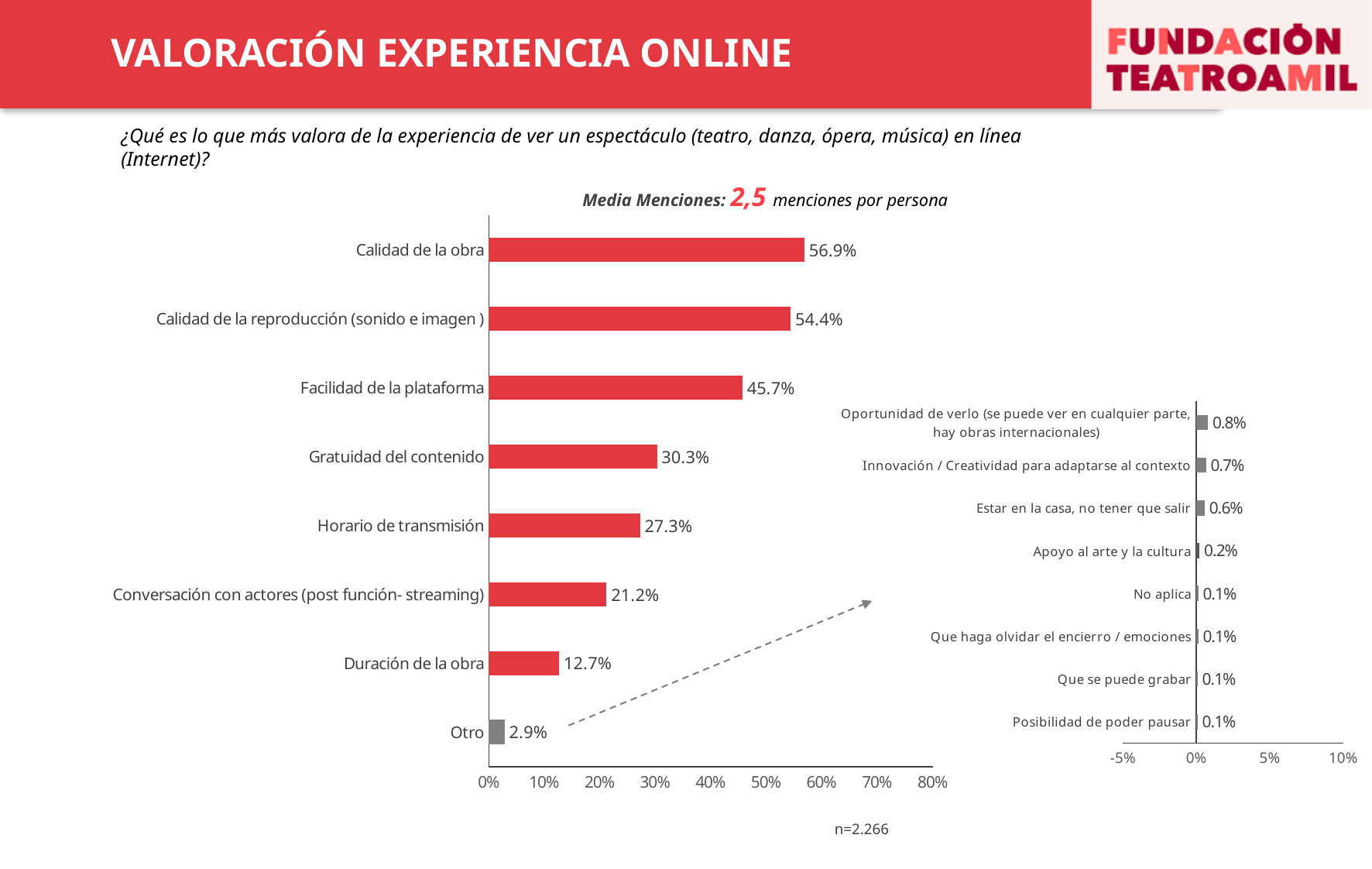
In the main chart on the left, which is larger: Gratuidad del contenido or Horario de transmisión? Gratuidad del contenido In the main chart on the left, what is the value for Calidad de la obra? 56.9% In the main chart on the left, what is the difference between Calidad de la obra and Calidad de la reproducción (sonido e imagen)? 2.5% In the main chart on the left, which category has the lowest value? Otro In the small chart on the right, which category has the highest value? Oportunidad de verlo (se puede ver en cualquier parte, hay obras internacionales) In the small chart on the right, what is the value for Estar en la casa, no tener que salir? 0.6% In the main chart on the left, which category has the highest value? Calidad de la obra In the small chart on the right, how many categories are shown? 8 In the main chart on the left, how many categories are shown? 8 What kind of chart is the main chart on the left? Bar chart In the main chart on the left, what is the value for Facilidad de la plataforma? 45.7% What is the Media Menciones (average mentions per person) shown above the main chart? 2,5